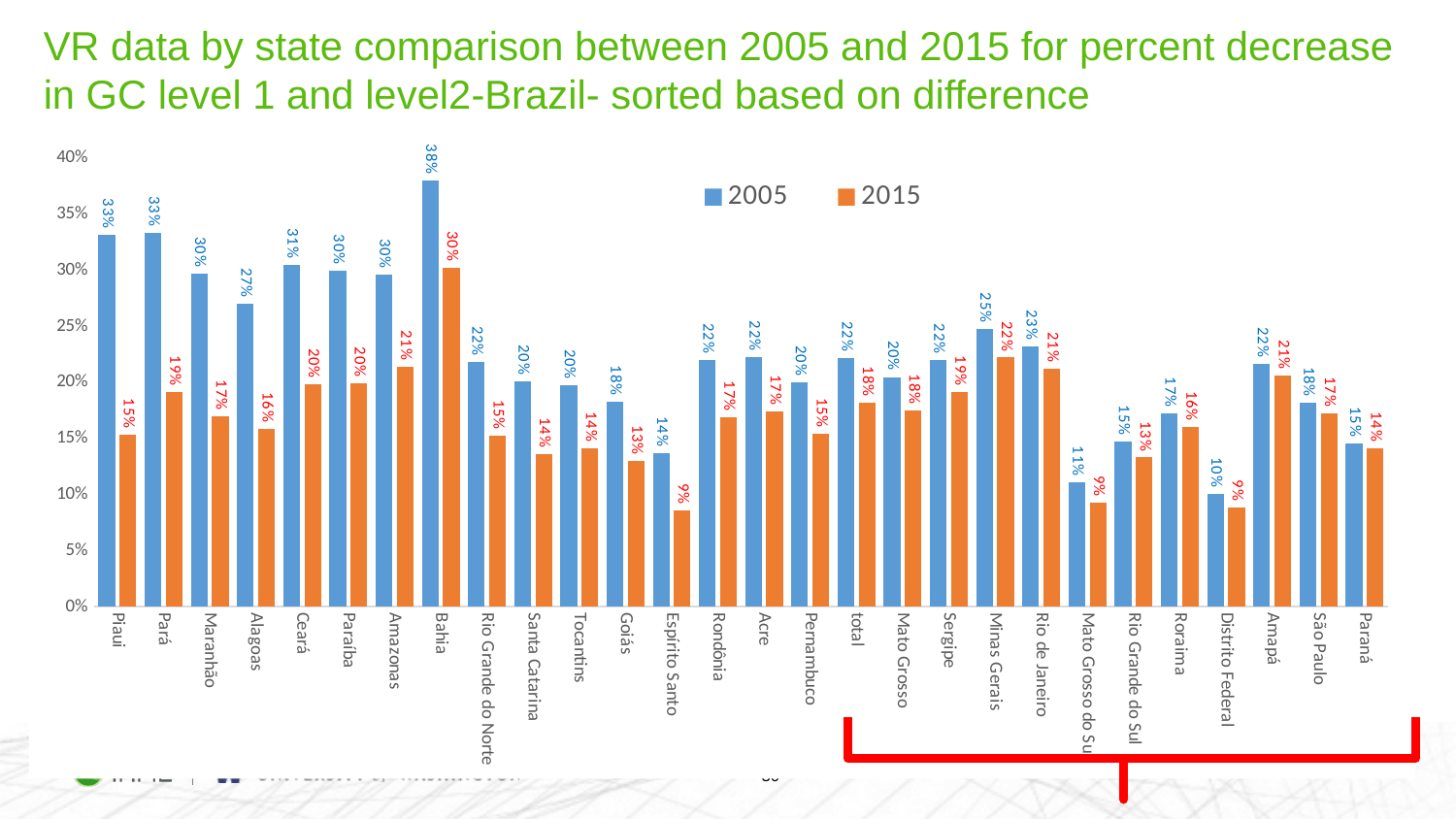
Which state has the highest 2005 value? Bahia What kind of chart is shown on the slide? bar chart What is the difference between the 2005 and 2015 values for Piauí? 18% Which category has the lowest 2005 value? Distrito Federal What is the 2015 value for Minas Gerais? 22% What is the 2015 value for Piauí? 15% Which is larger, the 2015 value for Bahia or the 2015 value for Amazonas? Bahia Which colour represents the 2015 series in the chart? orange How many series does the legend list? 2 What is the difference between the 2005 and 2015 values for Espírito Santo? 5% What is the 2005 value for Bahia? 38% Is the 2005 value for Mato Grosso do Sul greater or less than 15%? less